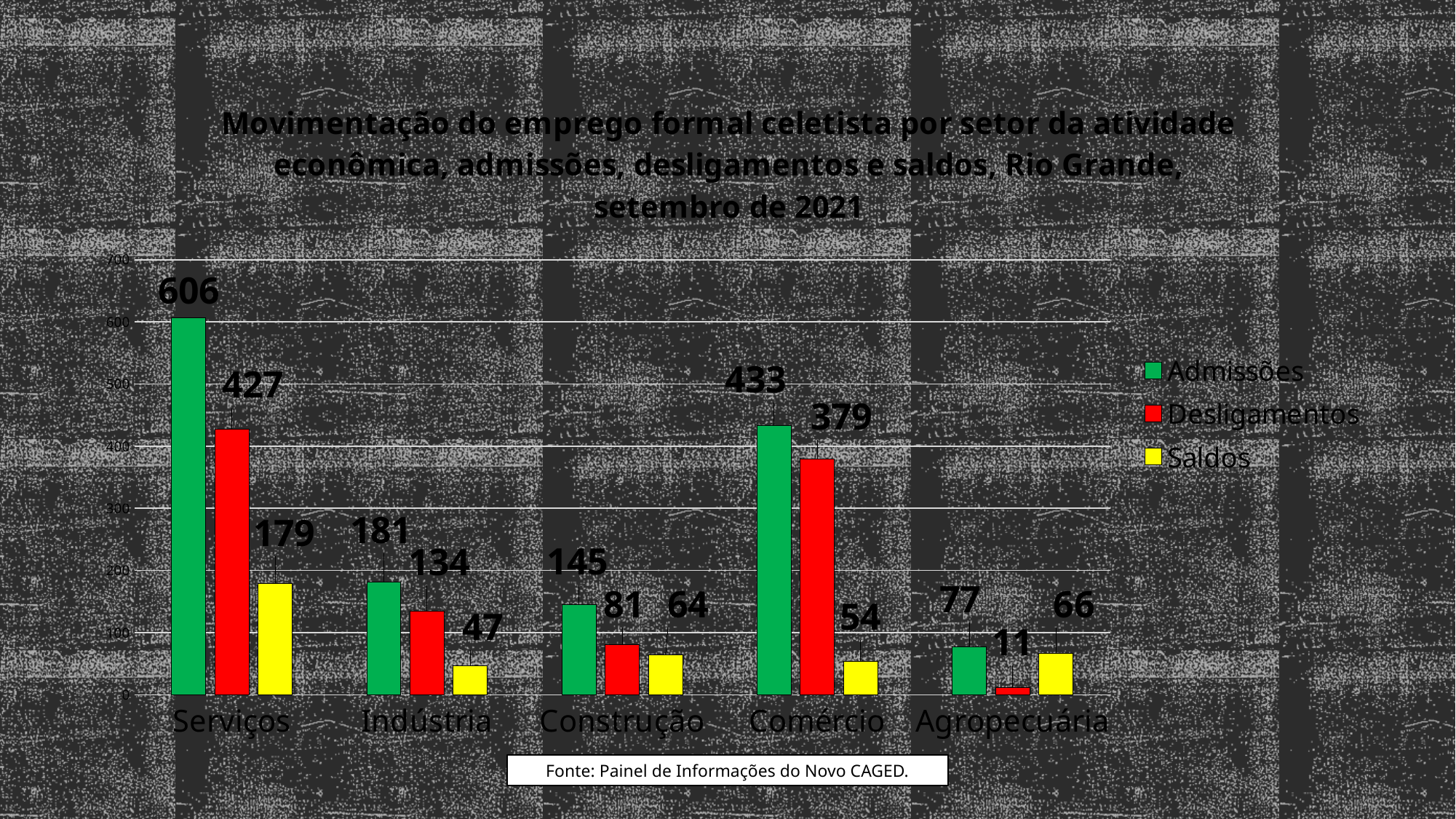
Which is larger, the Saldos value for Construção or the Saldos value for Comércio? Construção How many sectors are shown on the x axis? 5 Which sector has the highest Admissões value? Serviços What kind of chart is shown on the slide? bar chart What is the value of Saldos for Agropecuária? 66 Which sector has the lowest Desligamentos value? Agropecuária How many series does the legend list? 3 What is the value of Admissões for Serviços? 606 What is the value of Desligamentos for Comércio? 379 Which colour represents Saldos in the chart? yellow What is the difference between Admissões and Desligamentos for Indústria? 47 Is the Admissões value for Comércio greater or less than 400? greater